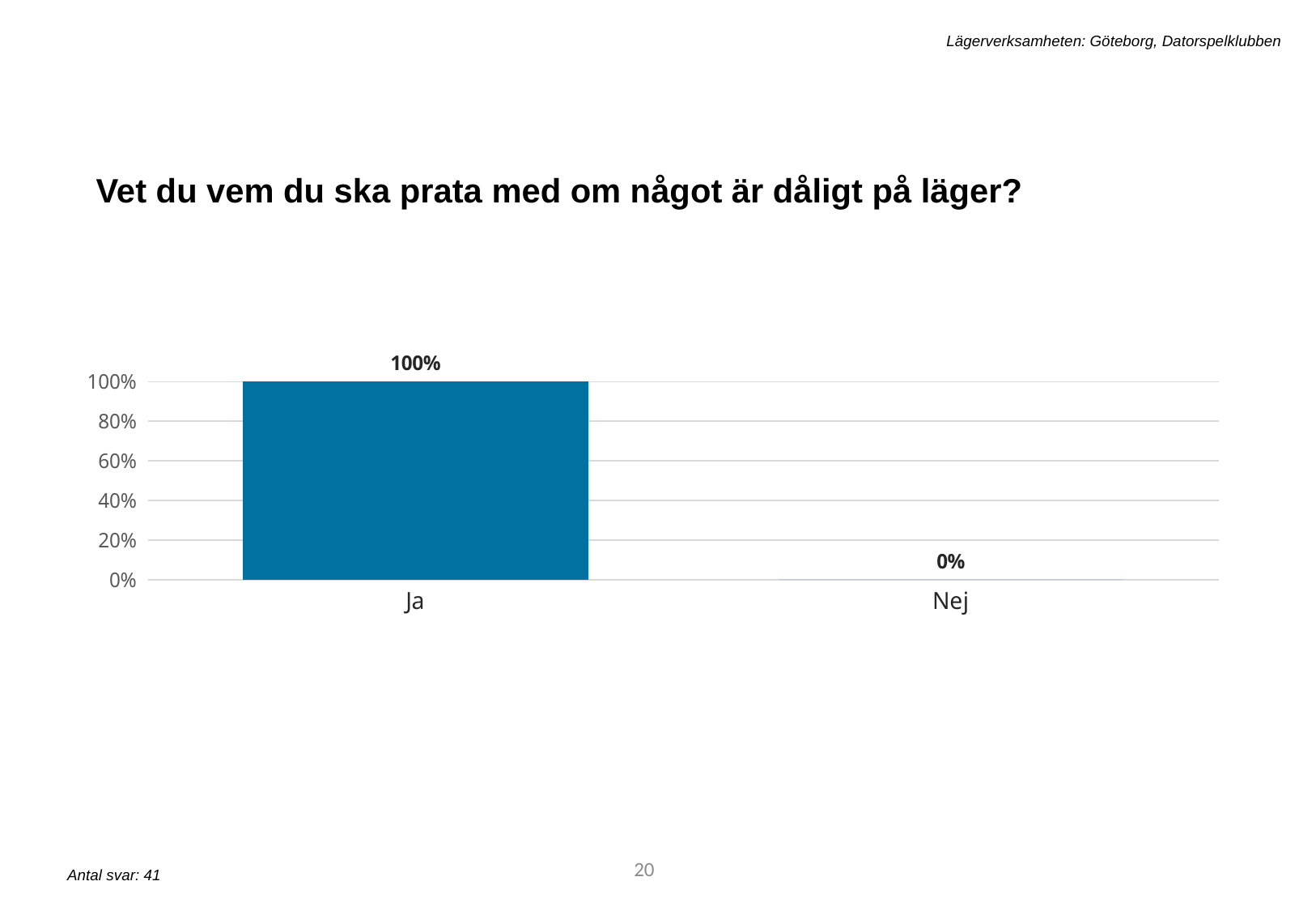
How many categories are shown on the x axis? 2 What kind of chart is shown on the slide? bar chart Do the values rise or fall from Ja to Nej? fall What is the value for Nej? 0% What is the difference between the values for Ja and Nej? 100% Which is larger, the value for Ja or the value for Nej? Ja What is the title of the chart? Vet du vem du ska prata med om något är dåligt på läger? Is the value for Ja greater or less than 80%? greater What is the value for Ja? 100% Which category has the highest value? Ja What is the highest value shown on the y axis? 100% Which category has the lowest value? Nej